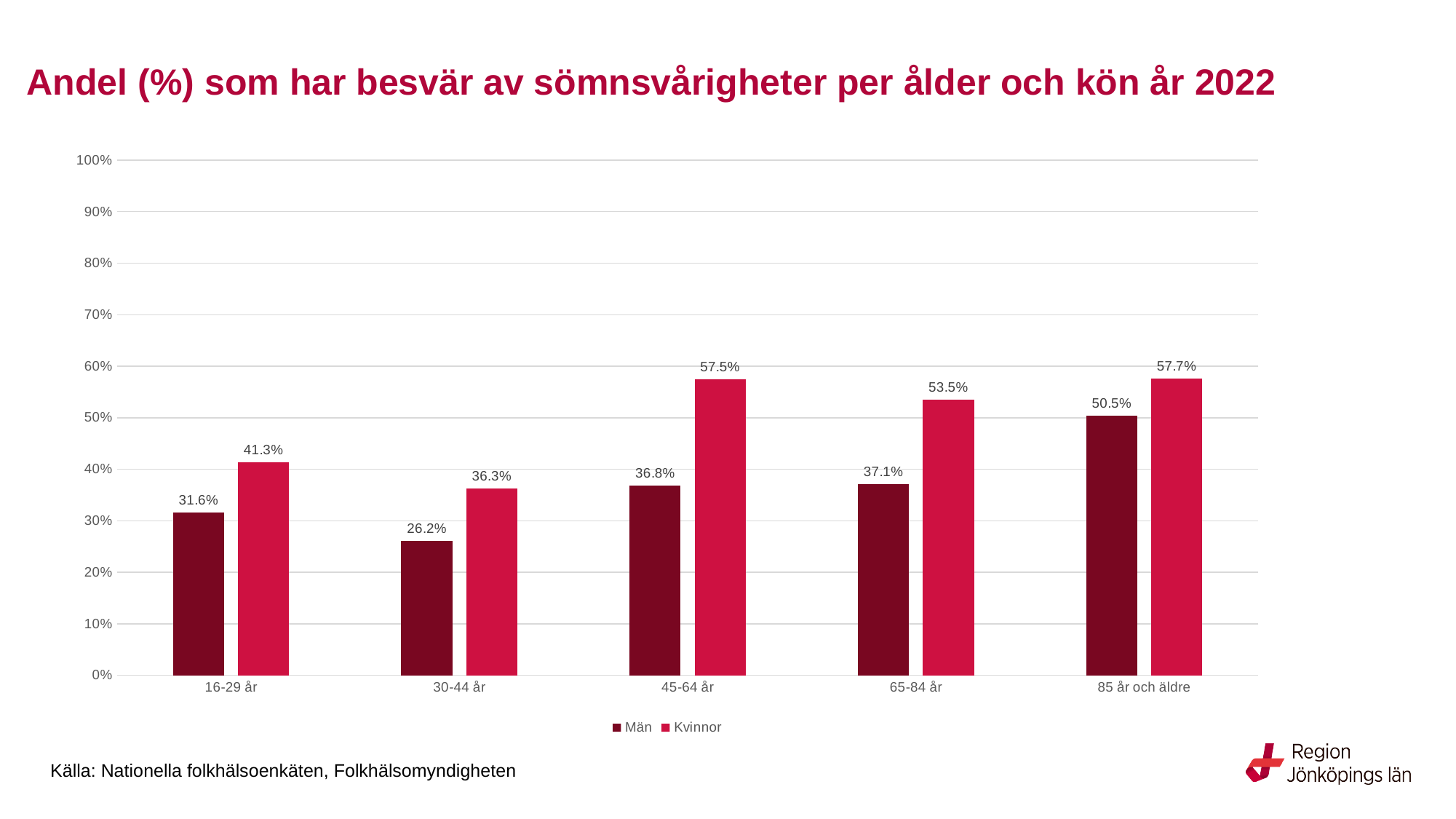
Which age group has the highest value for Kvinnor? 85 år och äldre How many series does the legend list? 2 What is the difference between Kvinnor and Män in the 16-29 år age group? 9.7 percentage points How many age groups are shown on the x axis? 5 Which is larger in the 65-84 år age group, Män or Kvinnor? Kvinnor What is the value for Kvinnor in the 45-64 år age group? 57.5% Is the value for Män in the 85 år och äldre age group greater or less than 50%? greater What kind of chart is shown on the slide? Bar chart What is the value for Män in the 16-29 år age group? 31.6% Which age group has the lowest value for Män? 30-44 år What is the difference between Kvinnor and Män in the 45-64 år age group? 20.7 percentage points What is the value for Män in the 85 år och äldre age group? 50.5%